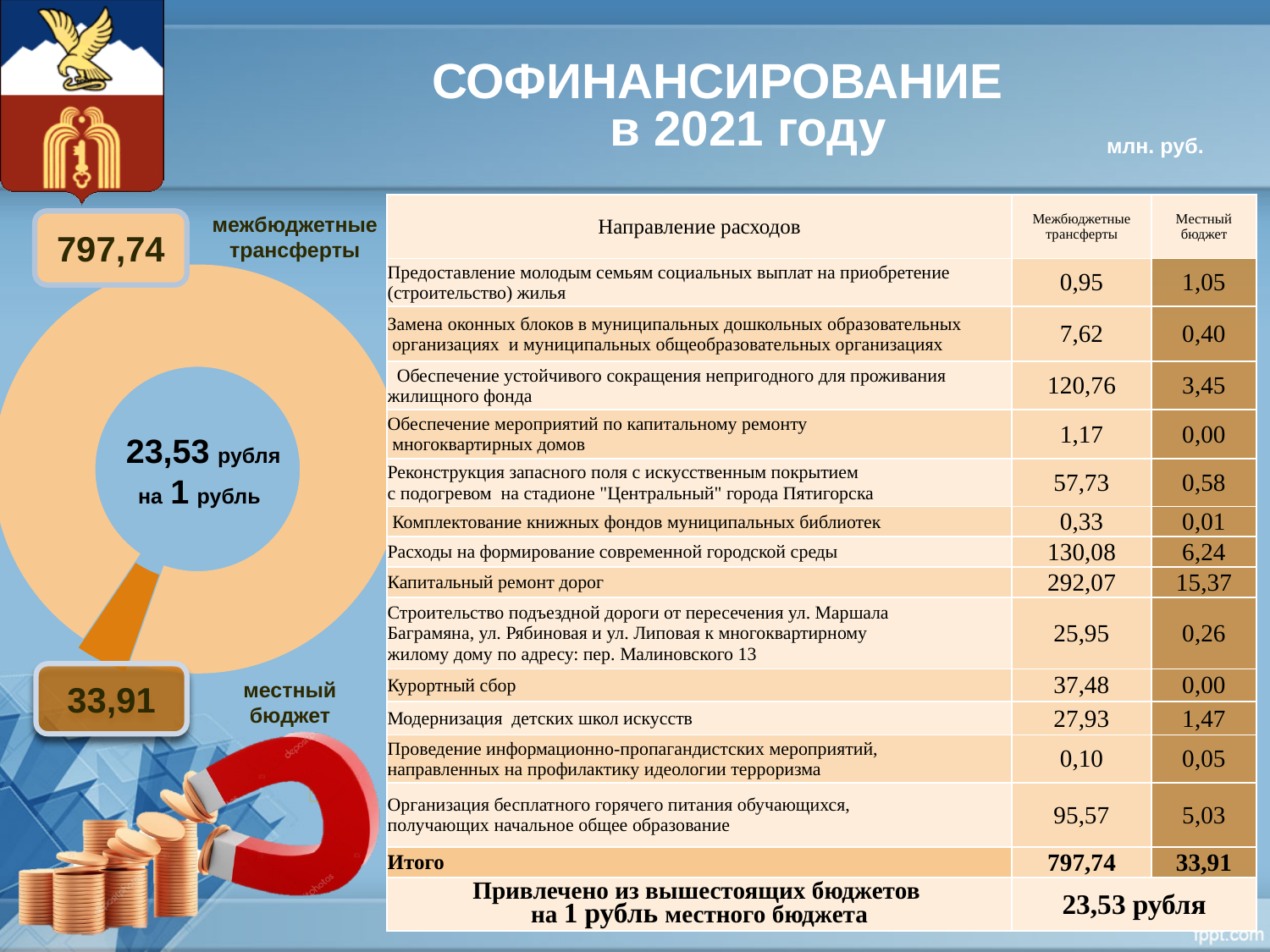
What unit is indicated for the values on the slide? млн. руб. What is the total of the two slices in the donut chart? 831,65 Which slice of the donut chart is the largest? межбюджетные трансферты Which is larger in the donut chart: межбюджетные трансферты or местный бюджет? межбюджетные трансферты Which slice of the donut chart is the smallest? местный бюджет What is the value for местный бюджет in the donut chart? 33,91 What is the value for межбюджетные трансферты in the donut chart? 797,74 How many slices does the donut chart on the left have? 2 What kind of chart is shown on the left of the slide? Donut (pie) chart What is the difference between межбюджетные трансферты and местный бюджет in the donut chart? 763,83 What text is shown in the centre of the donut chart? 23,53 рубля на 1 рубль